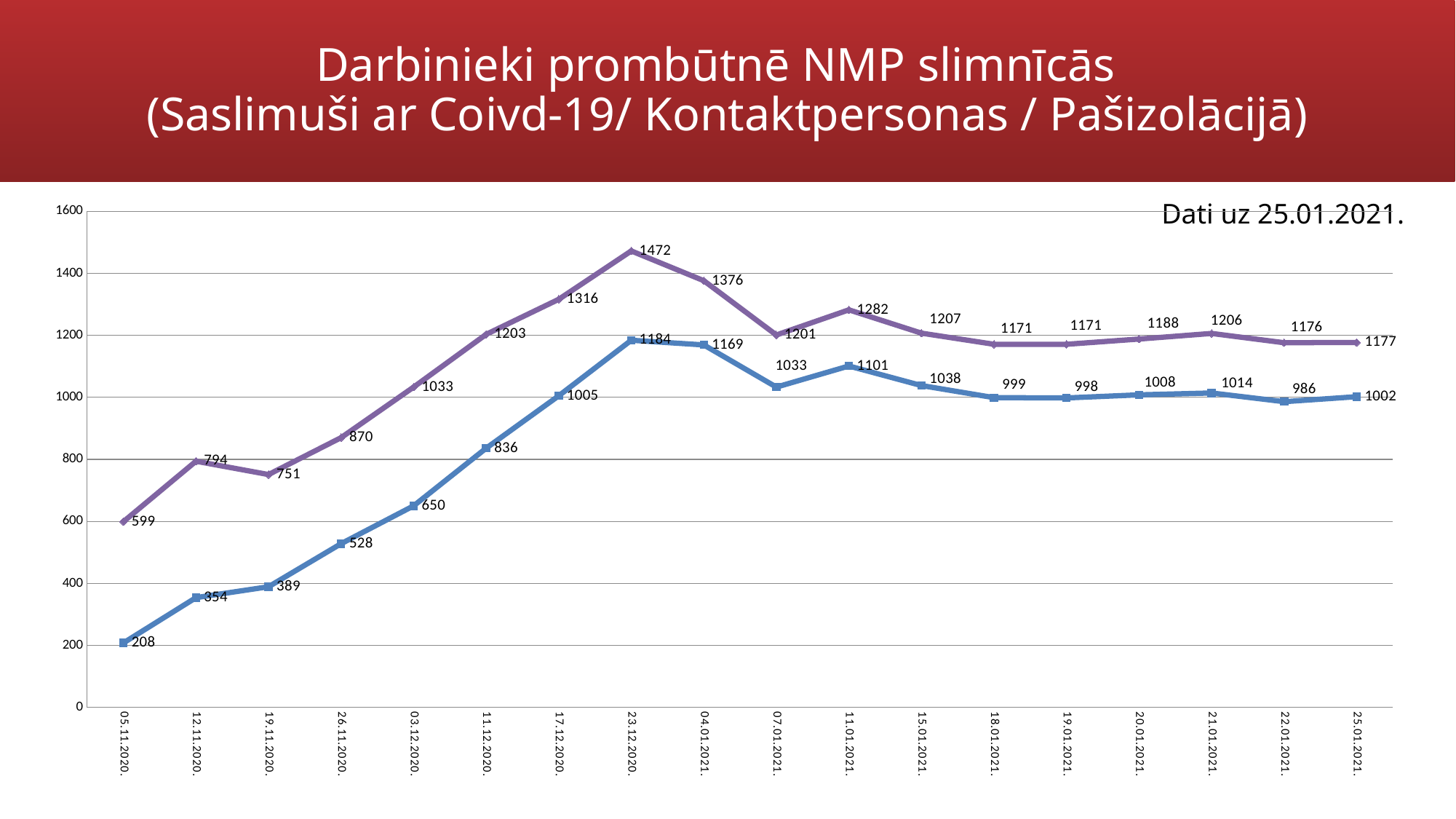
What type of chart is shown on the slide? line chart Which is larger: the blue line's value on 23.12.2020 or on 04.01.2021? 23.12.2020 What is the value of the blue line on 25.01.2021? 1002 On which date does the purple line reach its highest value? 23.12.2020 What is the value of the purple line on 23.12.2020? 1472 How many dates are plotted on the x axis? 18 Does the blue line rise or fall between 05.11.2020 and 23.12.2020? rise What date is given in the note 'Dati uz' at the top right of the chart? 25.01.2021. What is the value of the purple line on 15.01.2021? 1207 On which date does the blue line have its lowest value? 05.11.2020 What is the difference between the purple line and the blue line on 25.01.2021? 175 What is the value of the blue line on 05.11.2020? 208